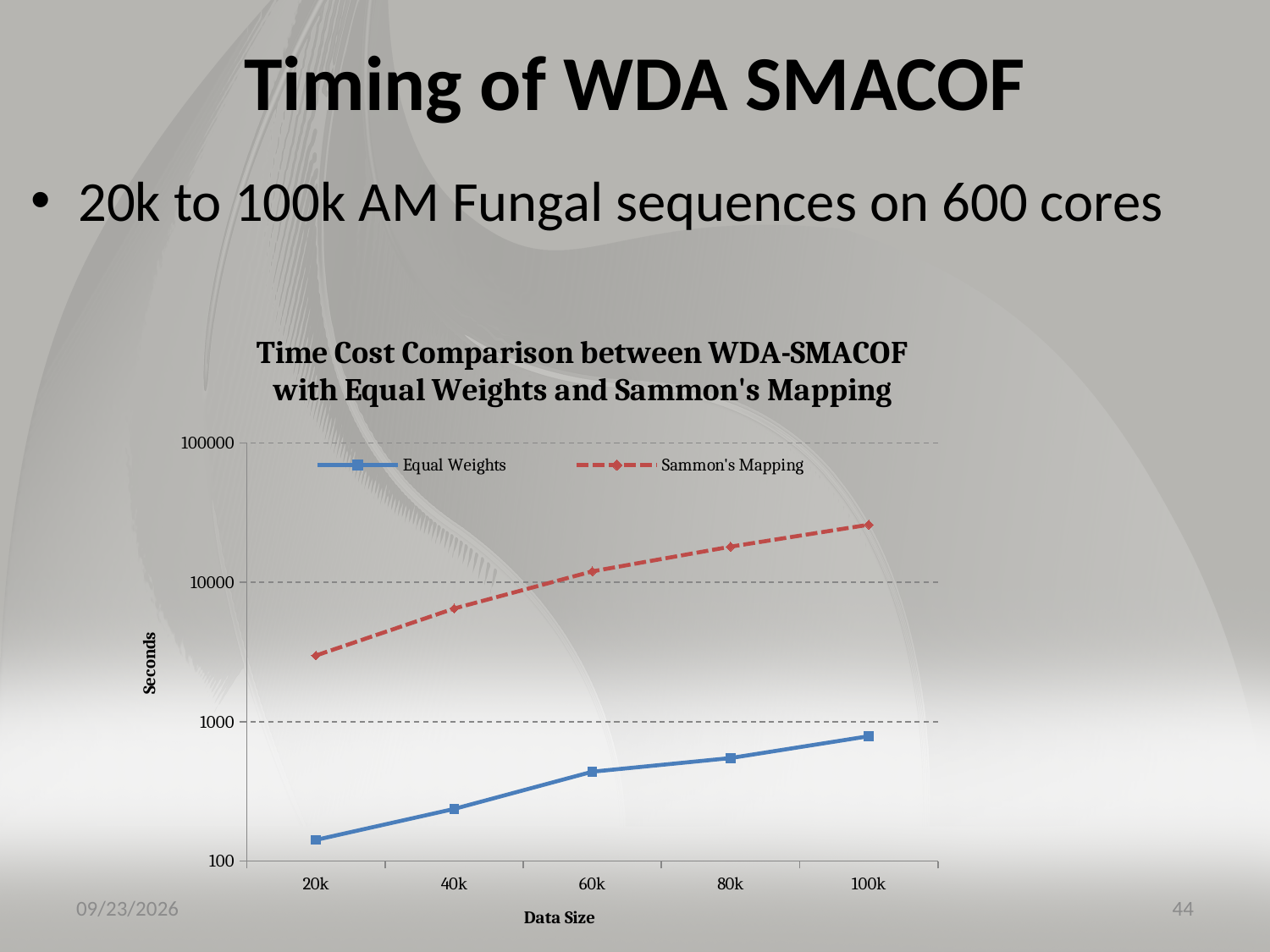
Is the value for Sammon's Mapping at 20k greater or less than 10000? less Do the values for Equal Weights rise or fall as the data size increases from 20k to 100k? rise Is the value for Equal Weights at 20k greater or less than 1000? less What is the title of the chart? Time Cost Comparison between WDA-SMACOF with Equal Weights and Sammon's Mapping What kind of chart is shown on the slide? line chart How many data sizes are plotted along the x axis? 5 Is the value for Equal Weights at 100k greater or less than 1000? less What is the label of the y axis? Seconds Which series has the larger value at 60k, Equal Weights or Sammon's Mapping? Sammon's Mapping How many series does the legend list? 2